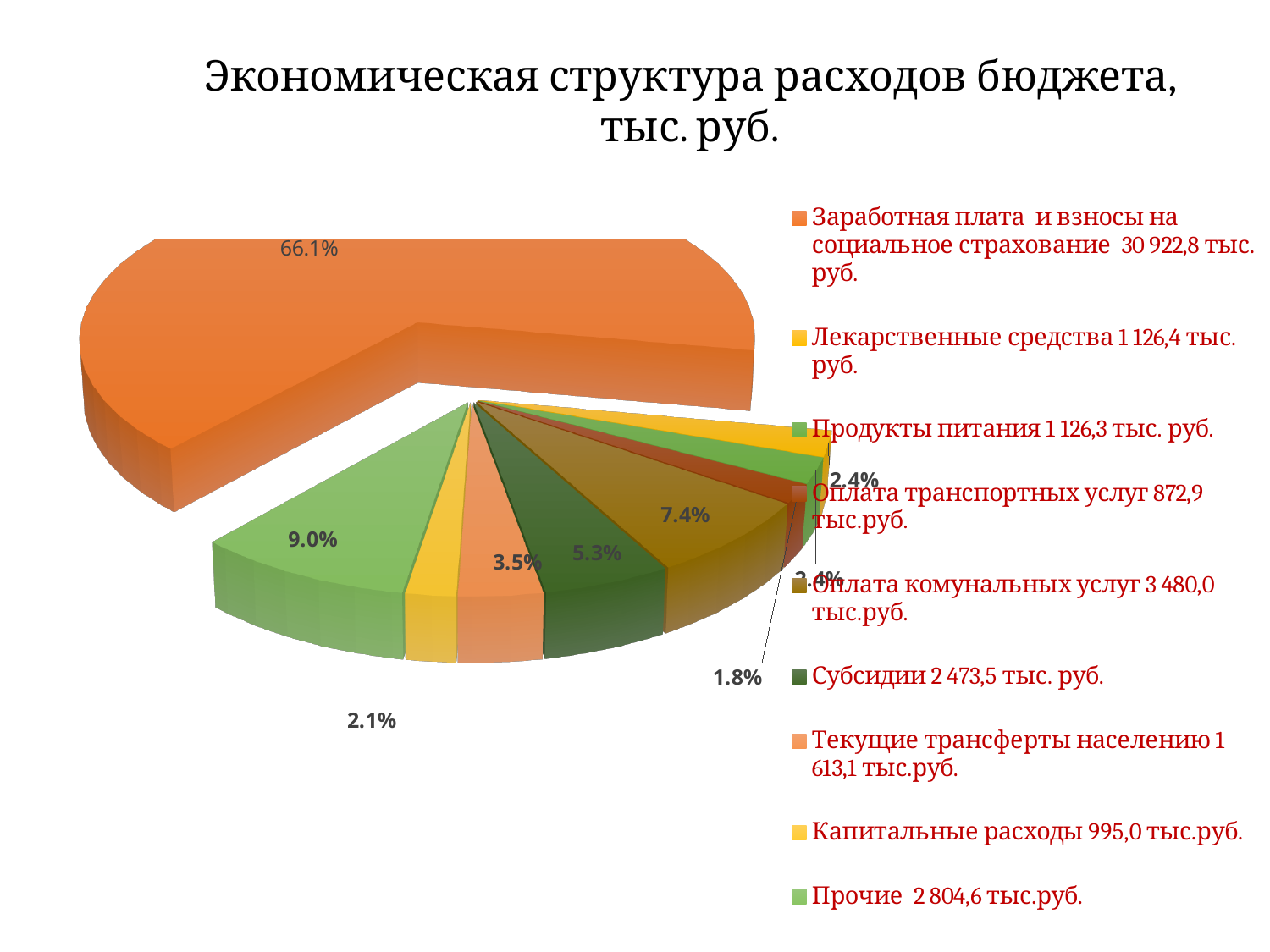
What share of the pie is labelled for Прочие? 9.0% Which has the larger share: Субсидии or Текущие трансферты населению? Субсидии According to the legend, what amount is given for Субсидии? 2 473,5 тыс. руб. What is the title of the chart? Экономическая структура расходов бюджета, тыс. руб. What share of the pie is labelled for Текущие трансферты населению? 3.5% What kind of chart is shown on the slide? Pie chart What is the difference in percentage points between the shares of Оплата комунальных услуг (7.4%) and Субсидии (5.3%)? 2.1 What share of the pie is labelled for Субсидии? 5.3% How many categories does the legend of the pie chart list? 9 Which category has the largest share of the pie chart? Заработная плата и взносы на социальное страхование